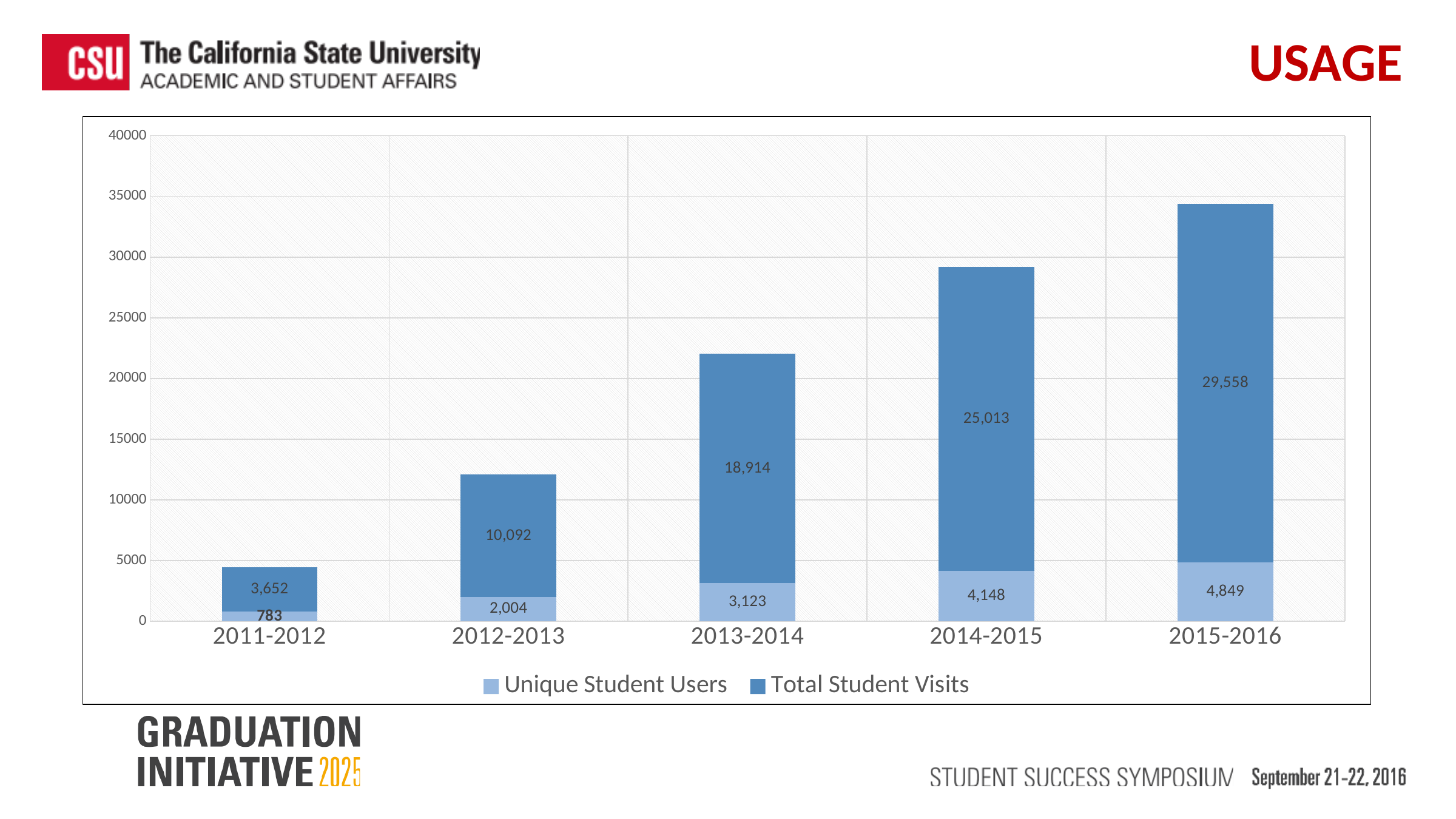
Which year has the lowest Unique Student Users? 2011-2012 Which series is shown in the lighter blue colour? Unique Student Users How many academic years are shown on the x axis? 5 What is the value of Total Student Visits for 2013-2014? 18,914 How many series does the legend list? 2 Which year has the highest Total Student Visits? 2015-2016 Do the Total Student Visits values rise or fall from 2011-2012 to 2015-2016? Rise What is the total height of the stacked bar for 2011-2012? 4,435 What is the value of Unique Student Users for 2012-2013? 2,004 Which is larger: Unique Student Users in 2014-2015 or in 2013-2014? 2014-2015 What is the difference in Total Student Visits between 2015-2016 and 2014-2015? 4,545 What kind of chart is shown on the slide? Stacked bar chart